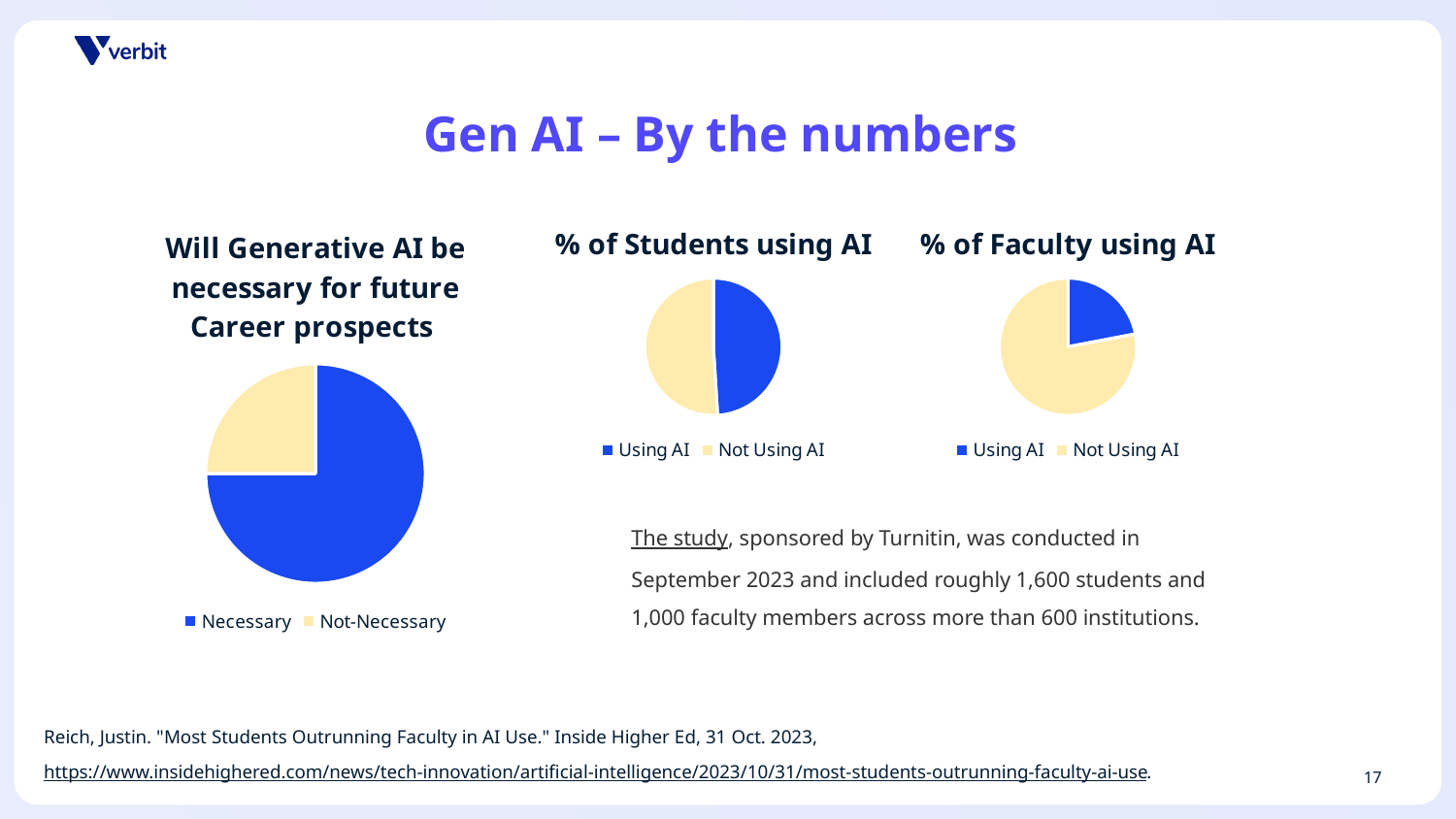
How many pie charts are shown on the slide? 3 In the "% of Faculty using AI" chart, which slice is the largest? Not Using AI In the "% of Faculty using AI" chart, which slice is the smallest? Using AI In the "% of Students using AI" chart, what colour represents the "Using AI" slice? Blue In the "Will Generative AI be necessary for future Career prospects" chart, which is larger: Necessary or Not-Necessary? Necessary In the "% of Faculty using AI" chart, which is larger: Using AI or Not Using AI? Not Using AI In the "Will Generative AI be necessary for future Career prospects" chart, which slice is the largest? Necessary What kind of chart is the "Will Generative AI be necessary for future Career prospects" chart? Pie chart What kind of chart is the "% of Faculty using AI" chart? Pie chart In the "Will Generative AI be necessary for future Career prospects" chart, which slice is the smallest? Not-Necessary How many slices does the "Will Generative AI be necessary for future Career prospects" pie chart have? 2 How many entries does the legend of the "% of Students using AI" chart list? 2